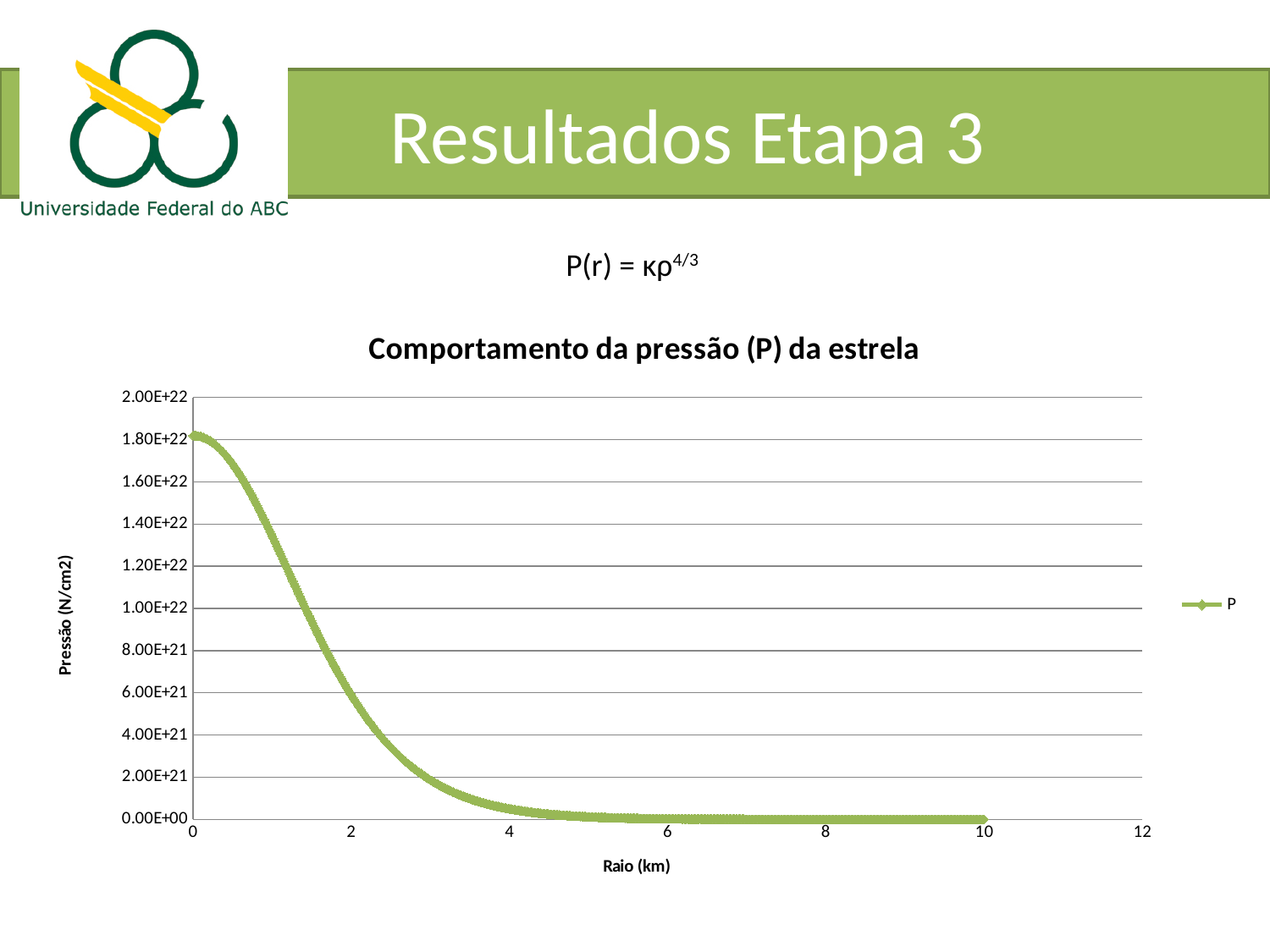
Is the pressure at Raio = 0 km greater or less than 1.60E+22? greater Is the pressure at Raio = 4 km greater or less than 2.00E+21? less How many series does the legend list? 1 Is the pressure at Raio = 2 km greater or less than 1.00E+22? less Which has the larger pressure: Raio = 2 km or Raio = 4 km? Raio = 2 km At which radius value is the pressure highest? 0 What is the title of the chart? Comportamento da pressão (P) da estrela What is the label of the series in the legend? P What kind of chart is shown on the slide? line chart What is the highest value shown on the y axis? 2.00E+22 Does the pressure rise or fall as the radius (Raio) increases? fall